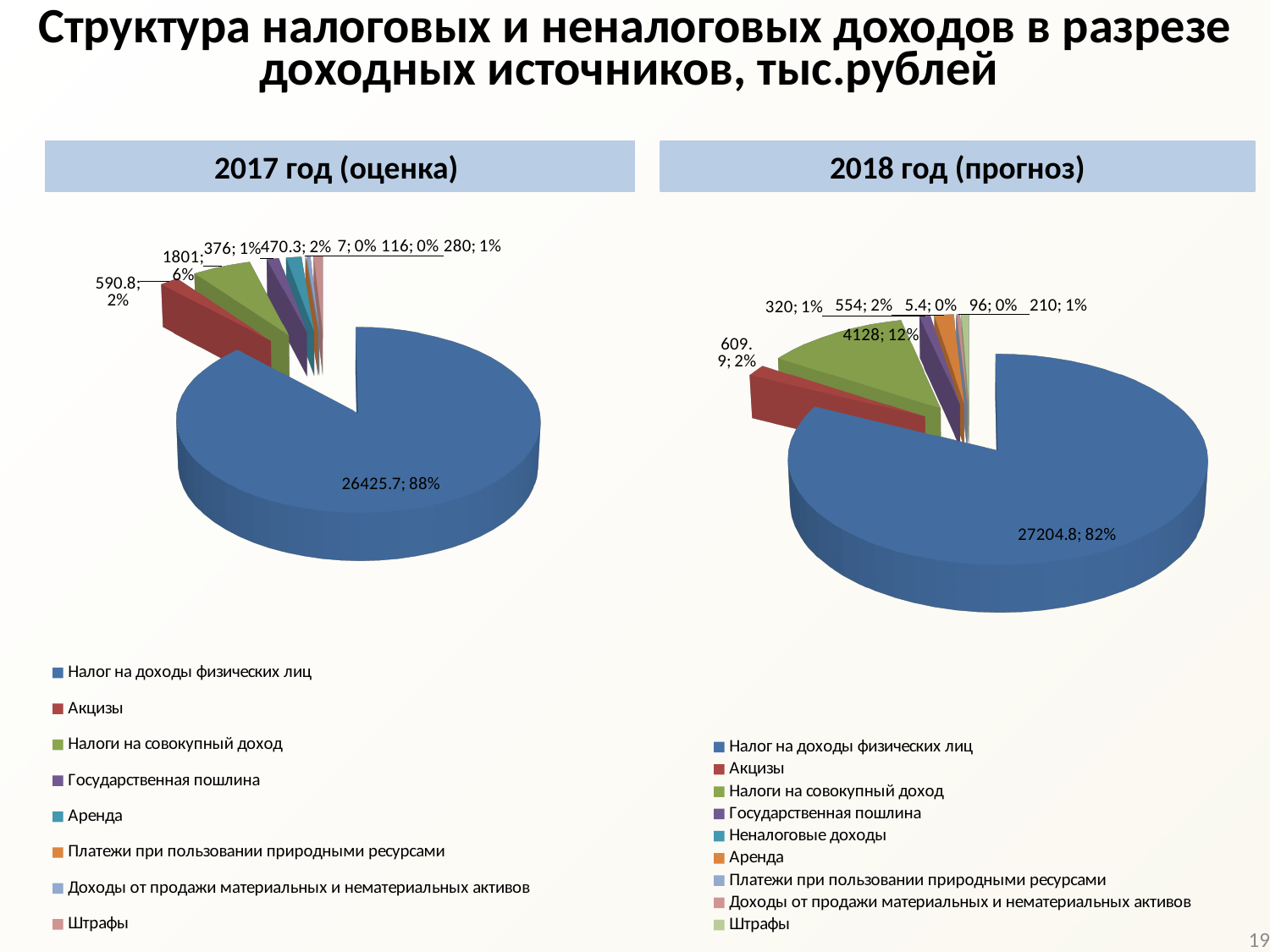
How many categories does the legend of the 2018 год (прогноз) chart list? 9 What kind of chart is used on this slide for the 2017 год (оценка) data? Pie chart In the 2018 год (прогноз) chart, what value is shown for Налоги на совокупный доход? 4128 In the 2018 год (прогноз) chart, what value is shown for Налог на доходы физических лиц? 27204.8 Which is larger: the value for Налоги на совокупный доход in the 2017 год (оценка) chart or in the 2018 год (прогноз) chart? 2018 год (прогноз) In the 2017 год (оценка) chart, what value is shown for Налог на доходы физических лиц? 26425.7 How many categories does the legend of the 2017 год (оценка) chart list? 8 In the 2018 год (прогноз) chart, what share of the pie does Налоги на совокупный доход take? 12% In the 2017 год (оценка) chart, what value is shown for Акцизы? 590.8 In the 2018 год (прогноз) chart, which category has the largest slice? Налог на доходы физических лиц By how much does the value for Налог на доходы физических лиц in the 2018 год (прогноз) chart exceed the value in the 2017 год (оценка) chart? 779.1 In the 2017 год (оценка) chart, what share of the pie does Налог на доходы физических лиц take? 88%